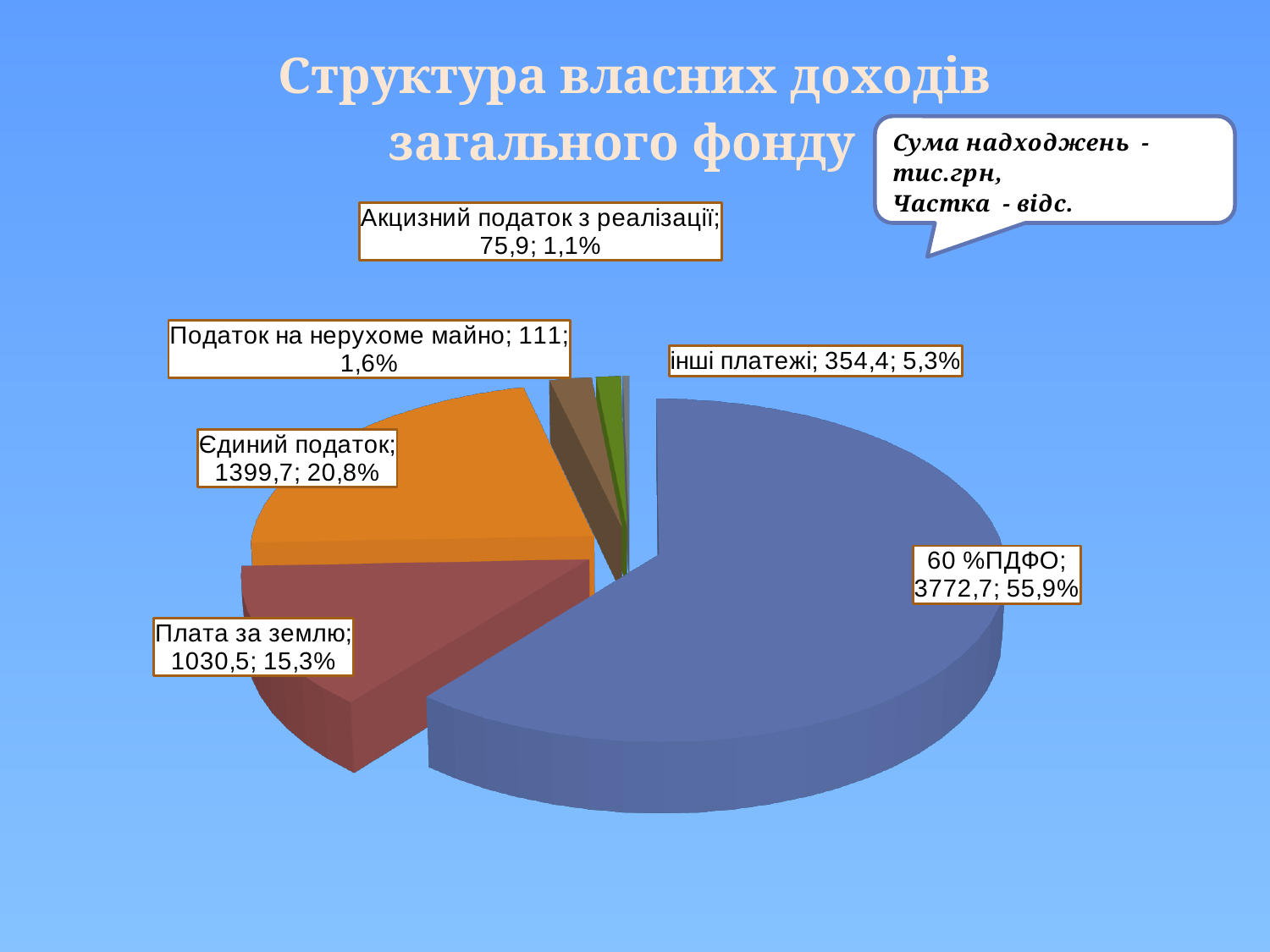
What is the title of the chart? Структура власних доходів загального фонду What is the amount shown for Плата за землю? 1030,5 What is the amount shown for Єдиний податок? 1399,7 What kind of chart is shown on the slide? pie chart What share of the pie does 60 %ПДФО represent? 55,9% How many slices does the pie chart have? 6 What share of the pie does Податок на нерухоме майно represent? 1,6% What is the difference between the amounts for Єдиний податок and Плата за землю? 369,2 What is the amount shown for інші платежі? 354,4 Which is larger, Єдиний податок or Плата за землю? Єдиний податок Which category has the largest slice? 60 %ПДФО